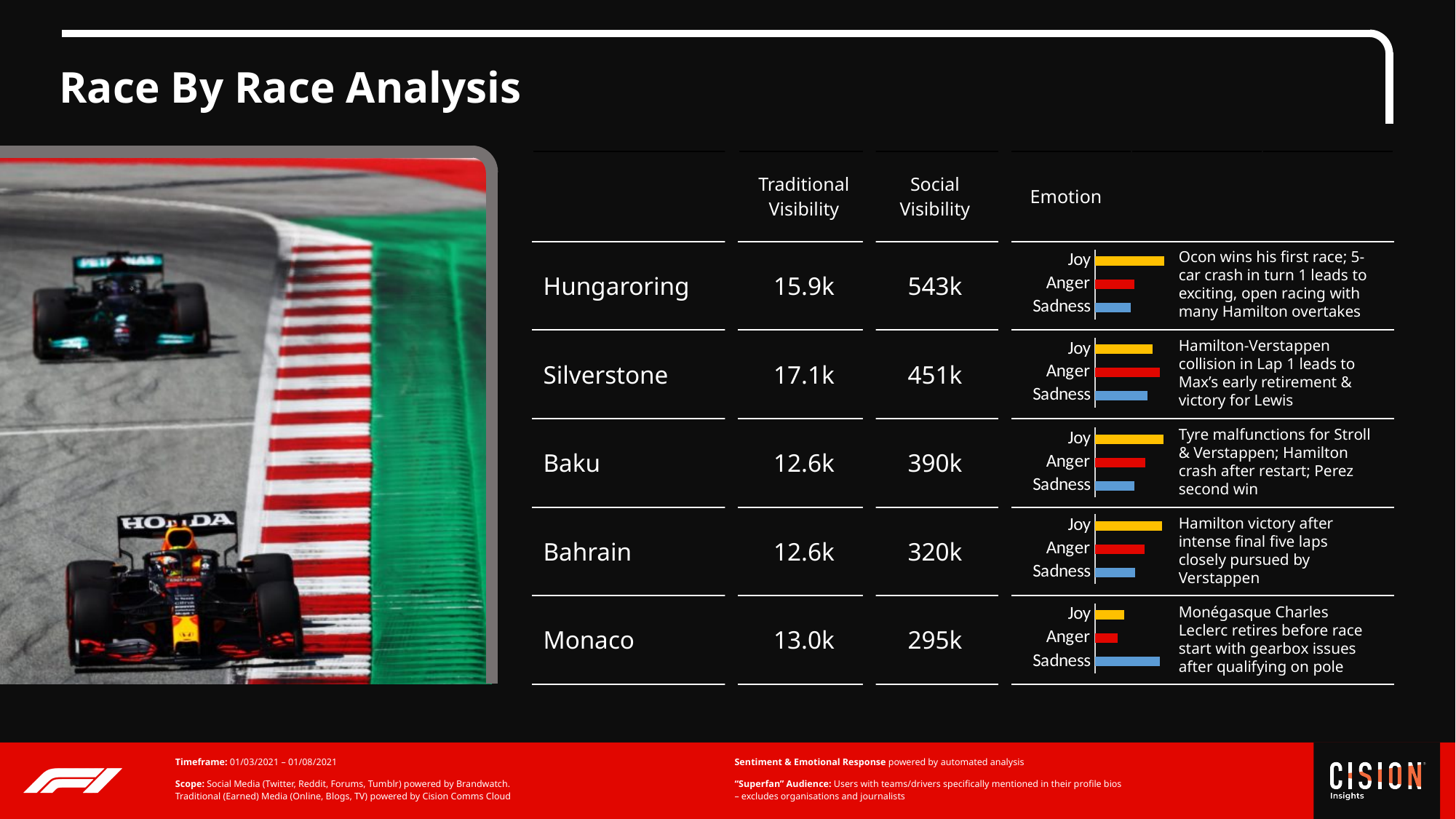
What kind of chart is used in the Emotion column for each race? bar chart In the Monaco Emotion chart, which emotion has the longest bar? Sadness How many races have an Emotion bar chart on the slide? 5 What colour are the Anger bars in the Emotion charts? red In the Hungaroring Emotion chart, is the bar for Joy or Anger longer? Joy In the Monaco Emotion chart, is the bar for Joy or Sadness longer? Sadness In the Hungaroring Emotion chart, which emotion has the longest bar? Joy What colour are the Joy bars in the Emotion charts? yellow How many emotion categories are plotted in each race's Emotion chart? 3 In the Bahrain Emotion chart, which emotion has the longest bar? Joy In the Baku Emotion chart, is the bar for Anger or Sadness longer? Anger